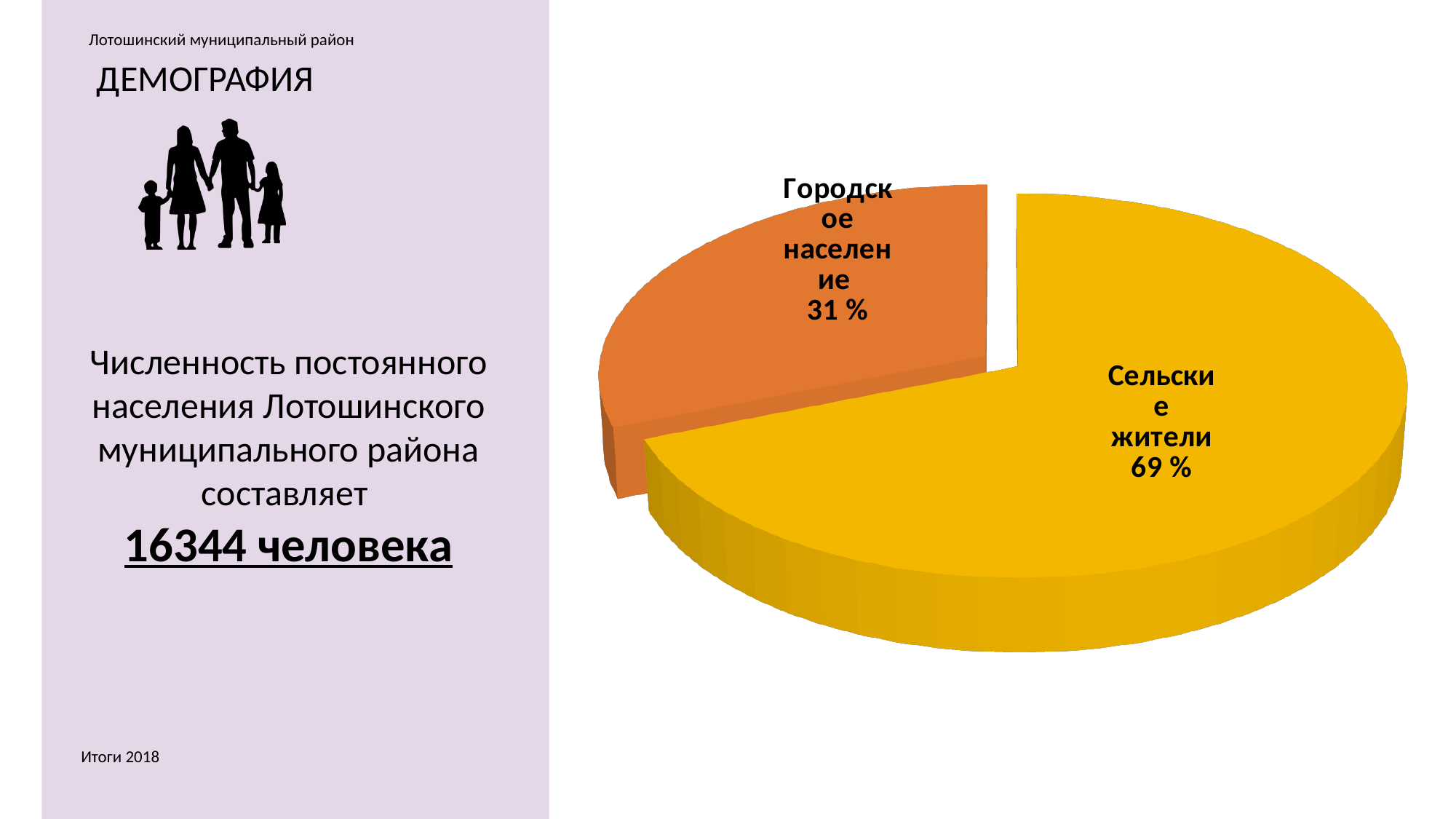
What colour is the slice for Сельские жители? yellow What share of the pie does Городское население have? 31 % What colour is the slice for Городское население? orange Which is larger, the share for Сельские жители or for Городское население? Сельские жители Is the share for Городское население greater or less than 50 %? less Which slice of the pie is the largest? Сельские жители What share of the pie does Сельские жители have? 69 % What kind of chart is shown on the slide? pie chart What is the difference in percentage points between Сельские жители and Городское население? 38 Which slice of the pie is the smallest? Городское население How many slices does the pie chart have? 2